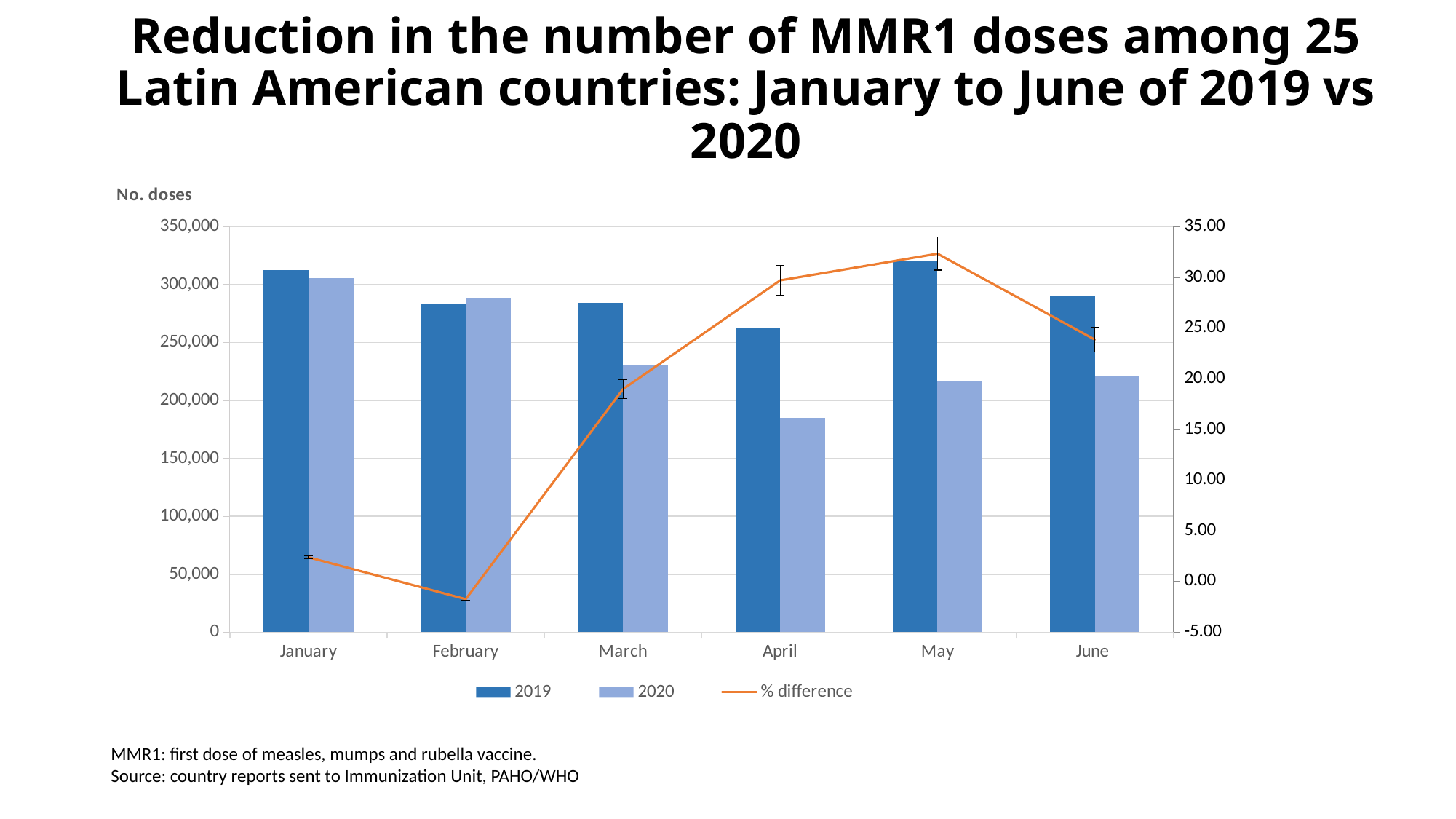
How many months are shown on the x axis of the chart? 6 Which month has the highest number of doses for 2020? January Is the number of doses for 2019 in May greater or less than 300,000? greater Which month has the lowest % difference? February How many series does the chart legend list? 3 Is the % difference for April greater or less than 25.00? greater What kind of chart is shown on the slide? A bar chart combined with a line chart In March, which series has the larger number of doses, 2019 or 2020? 2019 Which month has the lowest number of doses for 2020? April Which month has the highest number of doses for 2019? May Is the number of doses for 2020 in April greater or less than 200,000? less Does the % difference line rise or fall from February to May? rise